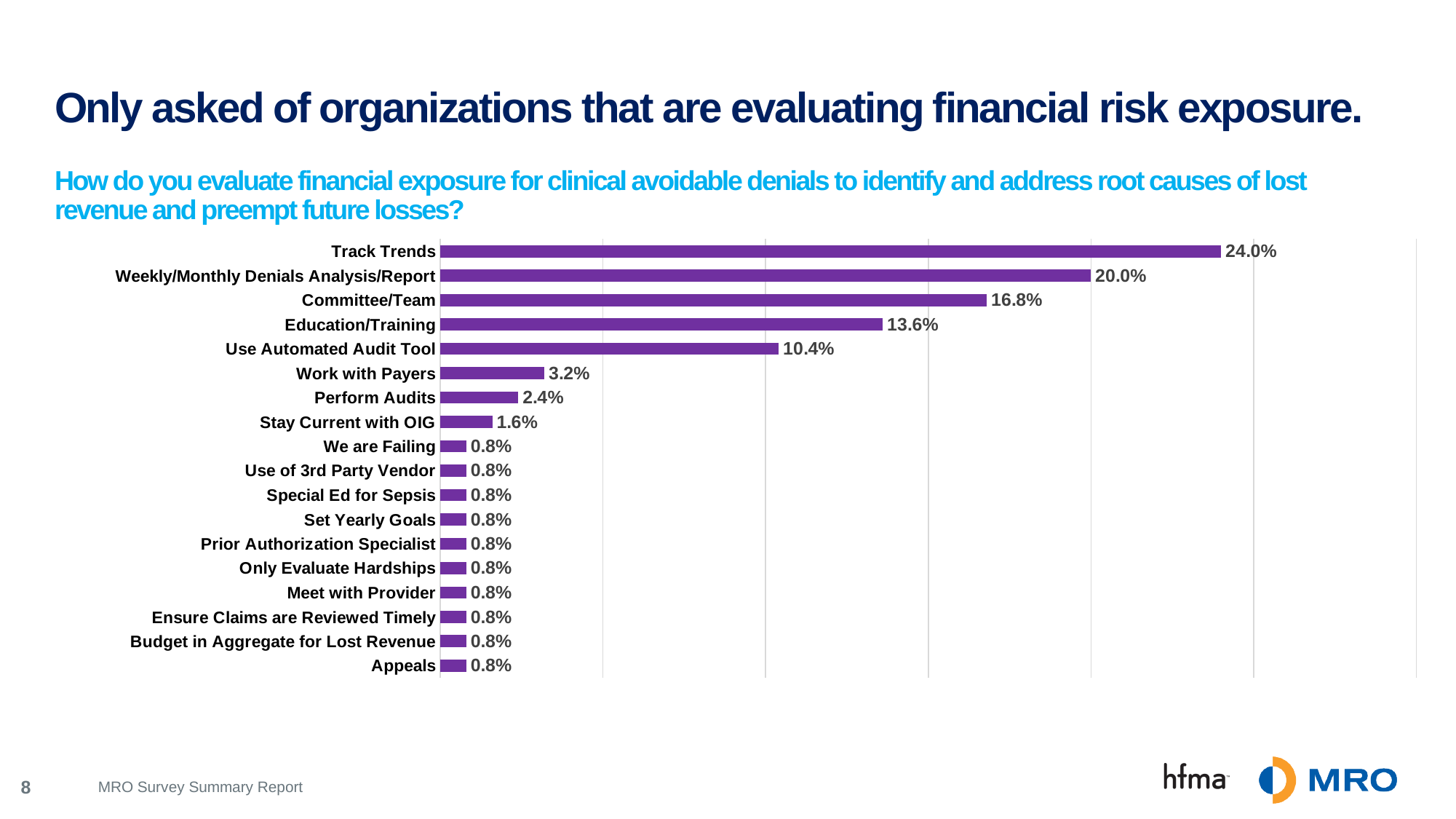
What kind of chart is shown on the slide? Bar chart Which is larger, Work with Payers or Perform Audits? Work with Payers What is the value for Stay Current with OIG? 1.6% Which is larger, Committee/Team or Education/Training? Committee/Team What is the difference between Track Trends and Weekly/Monthly Denials Analysis/Report? 4.0% How many categories are shown in the chart? 18 What is the value for Committee/Team? 16.8% What is the difference between Education/Training and Use Automated Audit Tool? 3.2% What is the value for Track Trends? 24.0% Which category has the highest value? Track Trends What is the value for Appeals? 0.8% What is the value for Use Automated Audit Tool? 10.4%